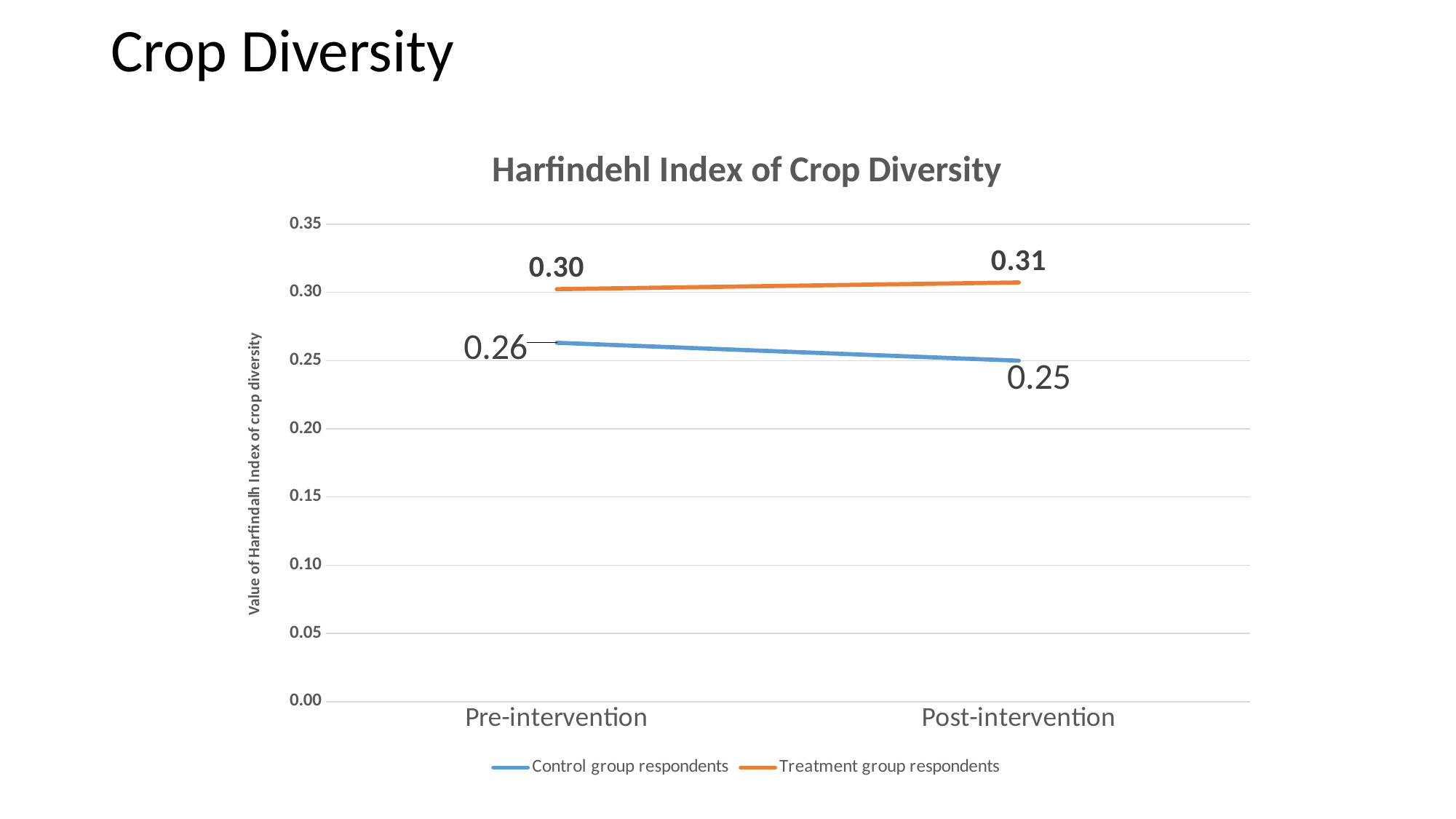
What is the value for Treatment group respondents at Pre-intervention? 0.30 What is the value for Control group respondents at Pre-intervention? 0.26 What is the value for Control group respondents at Post-intervention? 0.25 What is the value for Treatment group respondents at Post-intervention? 0.31 What is the difference between the Treatment group and Control group values at Pre-intervention? 0.04 How many categories are shown on the x axis? 2 Does the Treatment group respondents line rise or fall from Pre-intervention to Post-intervention? rise Does the Control group respondents line rise or fall from Pre-intervention to Post-intervention? fall What kind of chart is shown? line chart How many series does the legend list? 2 Which series has the higher value at Post-intervention? Treatment group respondents What is the difference between the Treatment group and Control group values at Post-intervention? 0.06